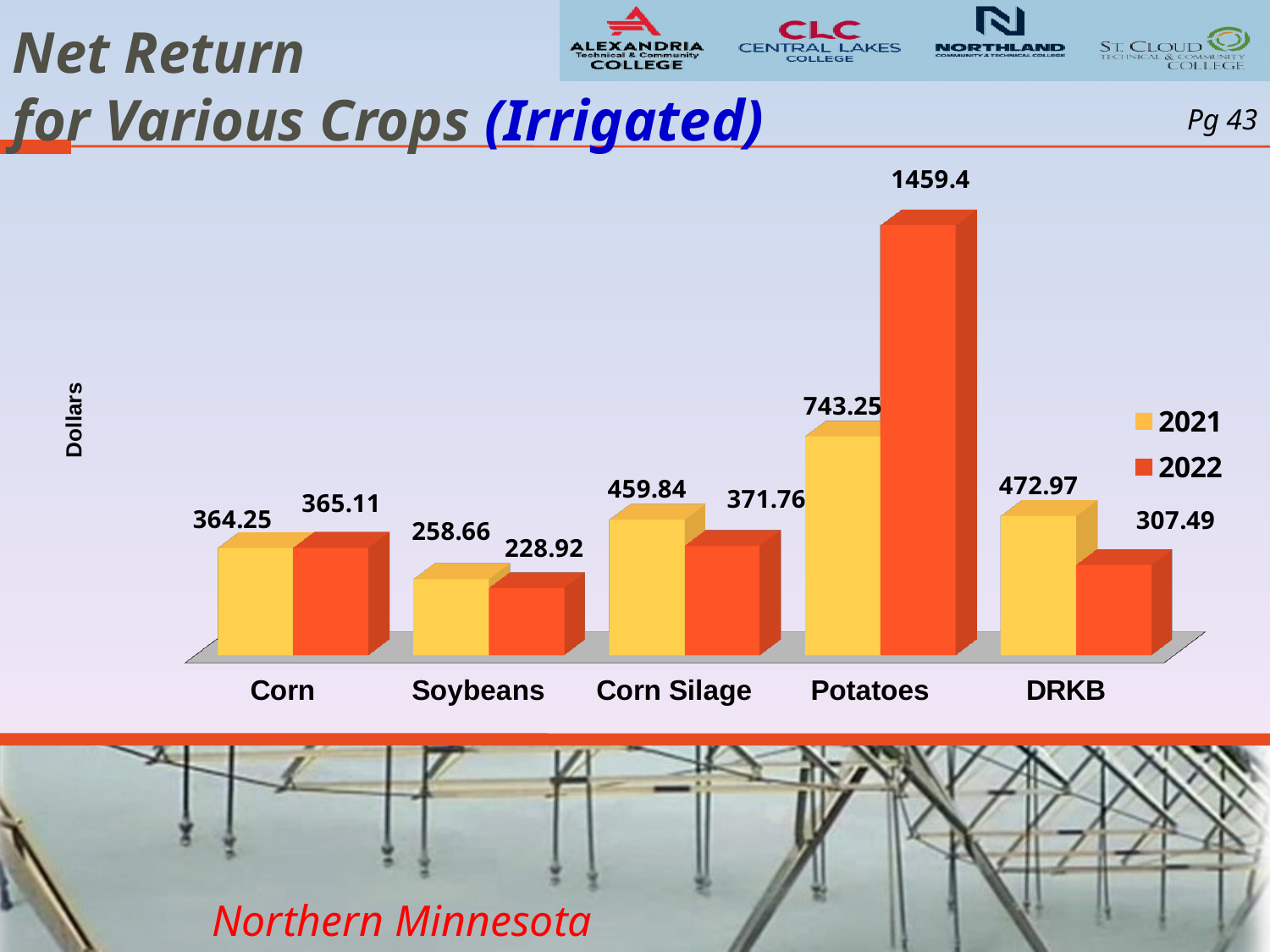
Which is larger for Corn Silage, the 2021 or the 2022 net return? 2021 What is the 2022 net return for DRKB? 307.49 What is the difference between the 2022 and 2021 net returns for Potatoes? 716.15 How many series does the legend list? 2 How many crops are shown on the x axis? 5 What is the 2021 net return for Soybeans? 258.66 What type of chart is shown on the slide? Bar chart Which crop has the lowest 2021 net return? Soybeans What is the 2021 net return for Corn Silage? 459.84 What is the difference between the 2021 and 2022 net returns for DRKB? 165.48 What is the 2022 net return for Potatoes? 1459.4 Which crop has the highest 2022 net return? Potatoes